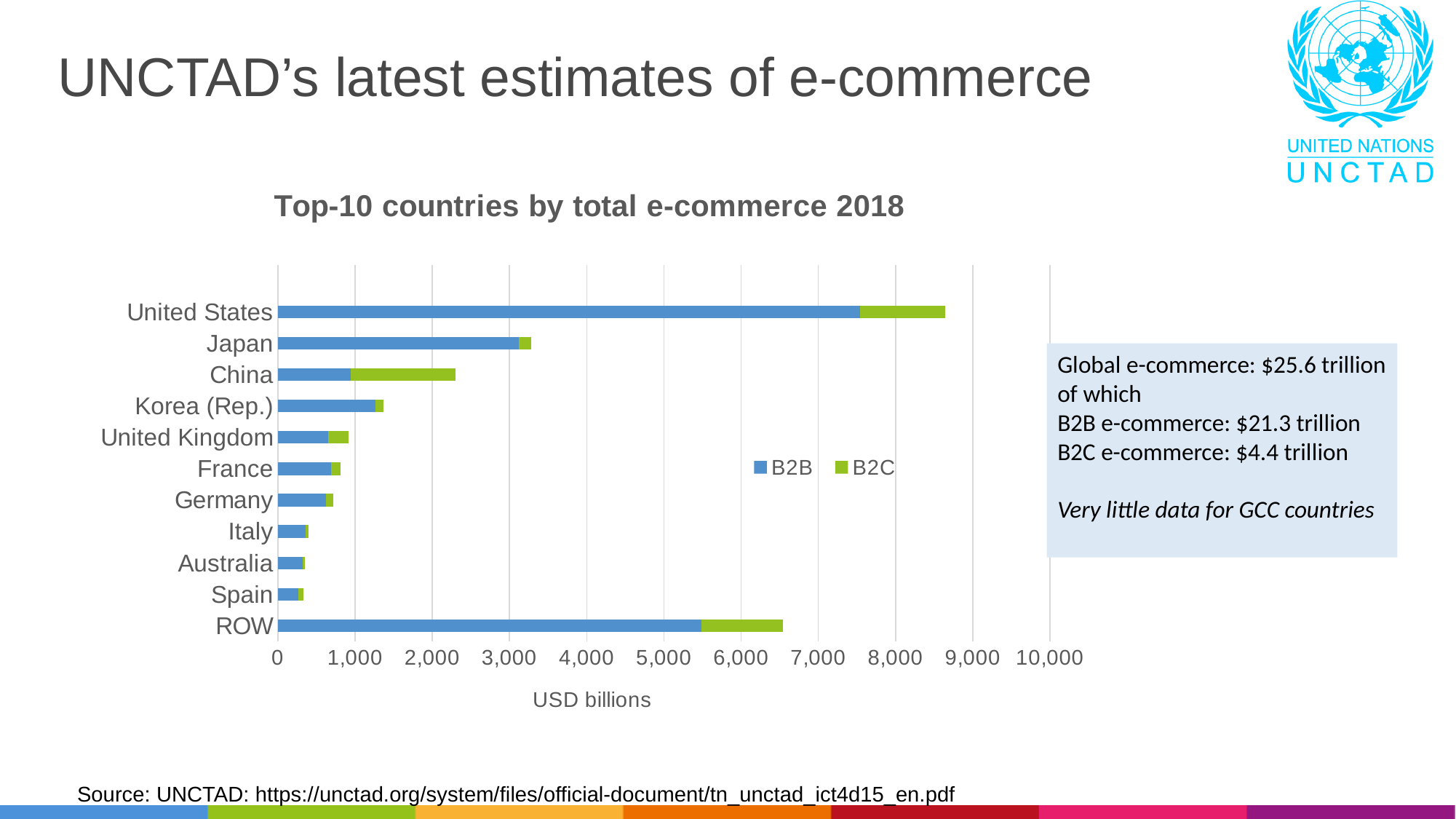
Which has a larger B2C value, China or Japan? China What is the title of the chart? Top-10 countries by total e-commerce 2018 How many series does the chart legend list? 2 Which has a larger total e-commerce value, Japan or China? Japan What unit is shown on the x axis of the chart? USD billions Is the total value for ROW greater or less than 6,000? greater How many categories are plotted on the chart? 11 Which category has the highest total e-commerce value? United States What kind of chart is shown on the slide? Stacked bar chart Is the total value for Japan greater or less than 3,000? greater Is the total value for the United States greater or less than 8,000? greater